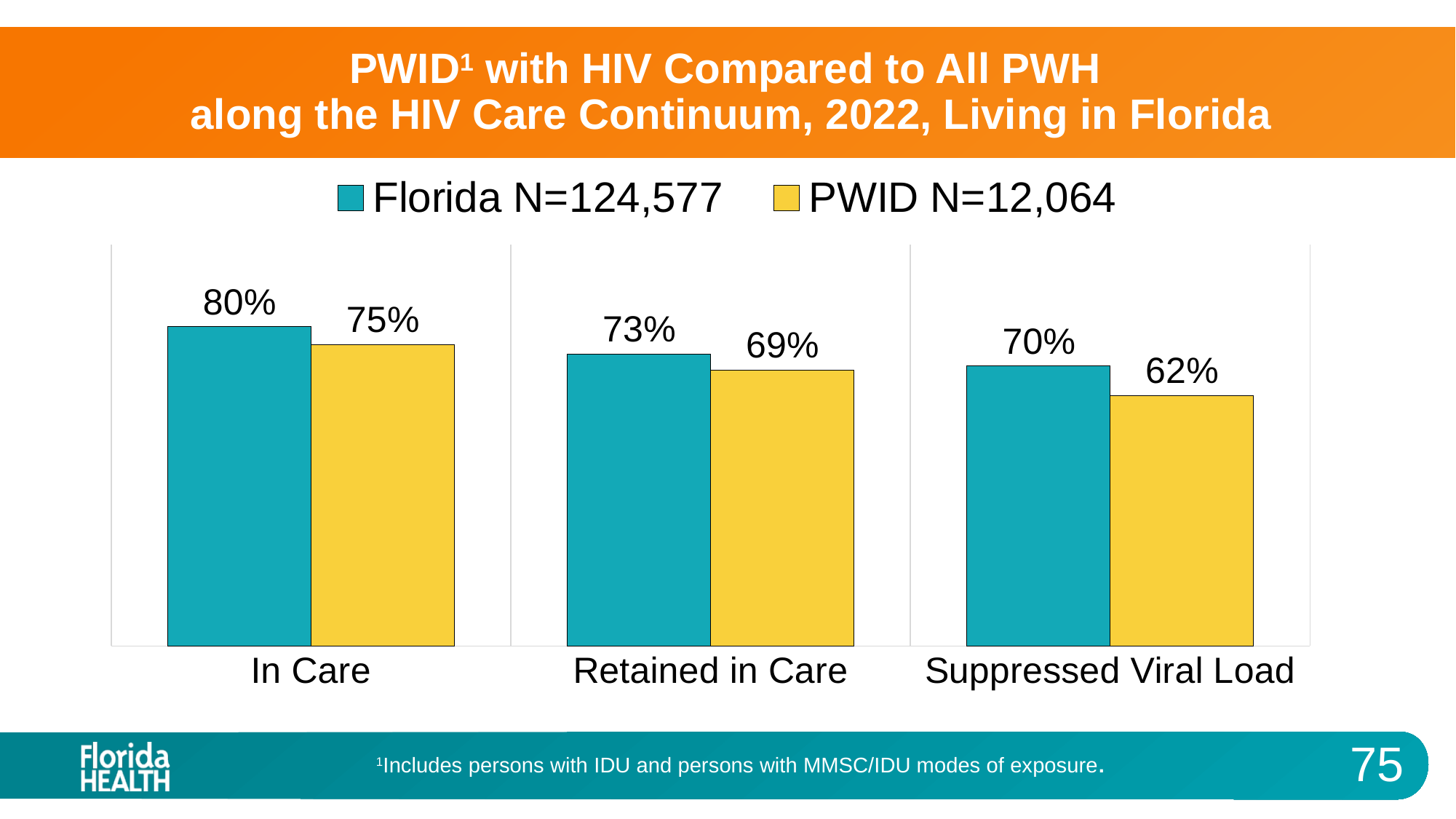
What is the difference between the Florida and PWID values for Suppressed Viral Load? 8% Which category has the lowest Florida value? Suppressed Viral Load What kind of chart is shown on the slide? Bar chart Which is larger for Retained in Care, the Florida value or the PWID value? Florida What is the PWID value for Suppressed Viral Load? 62% How many series does the legend list? 2 What is the difference between the Florida and PWID values for In Care? 5% Which category has the highest PWID value? In Care How many categories are shown on the x axis? 3 What is the Florida value for In Care? 80% What is the PWID value for Retained in Care? 69% What is the Florida value for Suppressed Viral Load? 70%